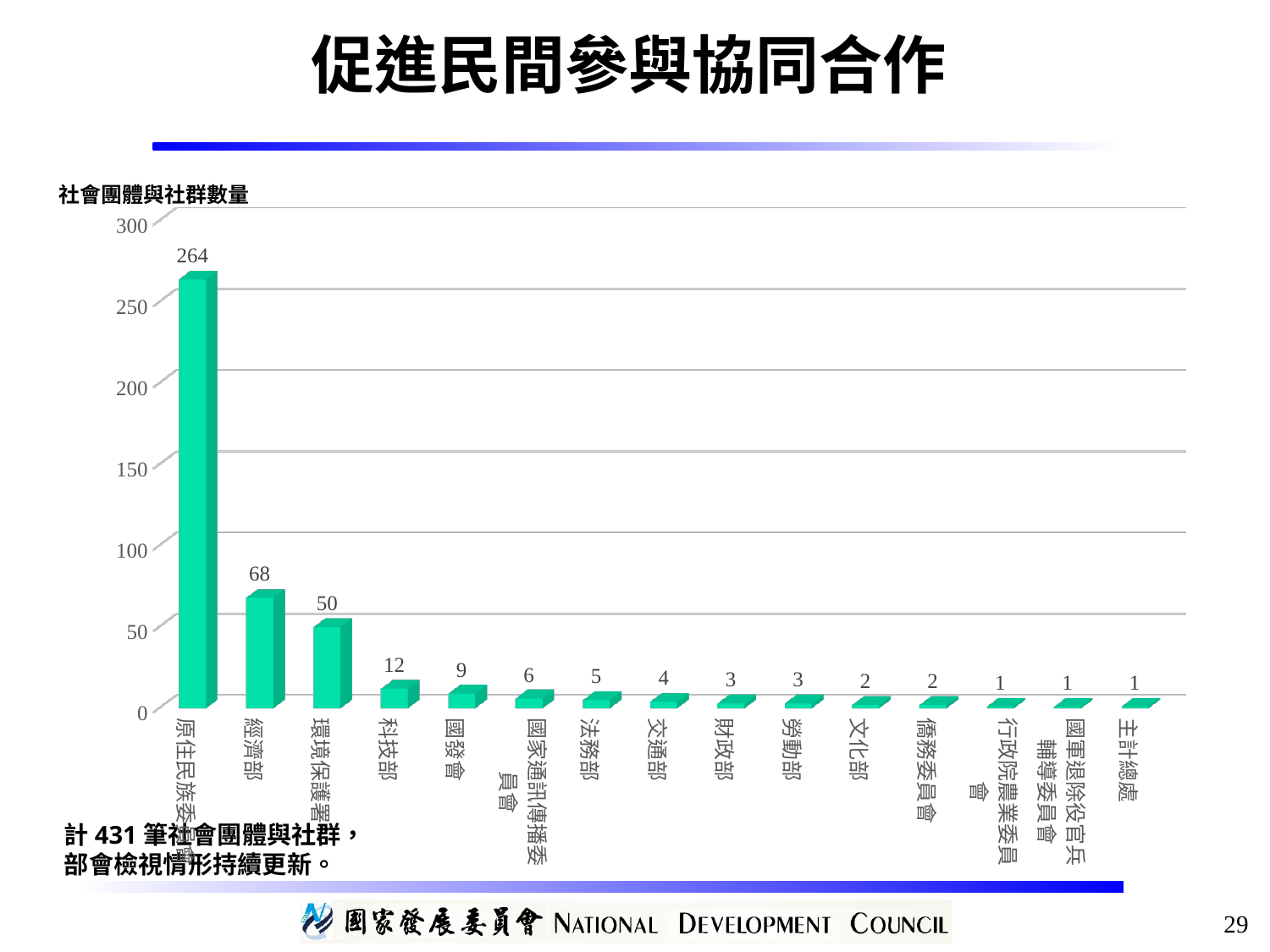
What is the value for 環境保護署? 50 What is the title of the chart? 社會團體與社群數量 Is the value for the first bar (原住民族委員會) greater or less than 250? greater How many categories (ministries/agencies) are shown on the x axis of the chart? 15 Which has a larger value, 交通部 or 文化部? 交通部 What is the value for 經濟部? 68 What is the value for 科技部? 12 Which category has the highest value in the chart? 原住民族委員會 What is the value for 國發會? 9 What is the value for 法務部? 5 What is the difference between the values for 經濟部 and 環境保護署? 18 What type of chart is shown on the slide? bar chart